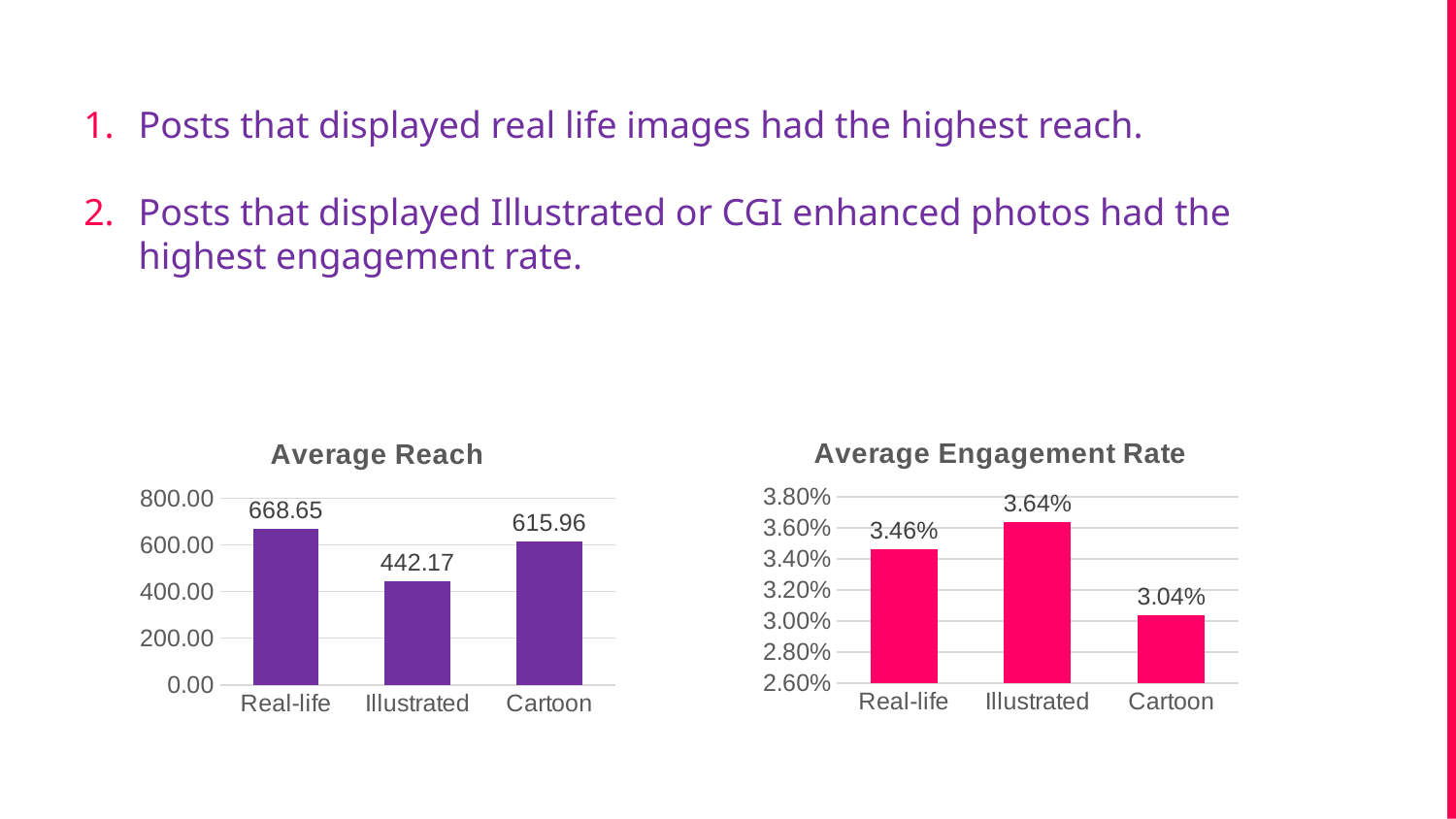
In the Average Engagement Rate chart, what is the difference between the values for Illustrated and Real-life? 0.18% In the Average Reach chart, is the value for Cartoon greater or less than 600.00? greater In the Average Reach chart, what is the difference between the values for Real-life and Cartoon? 52.69 In the Average Engagement Rate chart, what is the value for Cartoon? 3.04% What is the title of the chart on the right side of the slide? Average Engagement Rate In the Average Reach chart, which category has the lowest value? Illustrated In the Average Engagement Rate chart, which is larger, the value for Real-life or the value for Cartoon? Real-life In the Average Engagement Rate chart, which category has the highest value? Illustrated In the Average Reach chart, what is the value for Illustrated? 442.17 How many categories are shown in the Average Engagement Rate chart? 3 What kind of chart is the Average Reach chart? bar chart In the Average Reach chart, what is the value for Real-life? 668.65